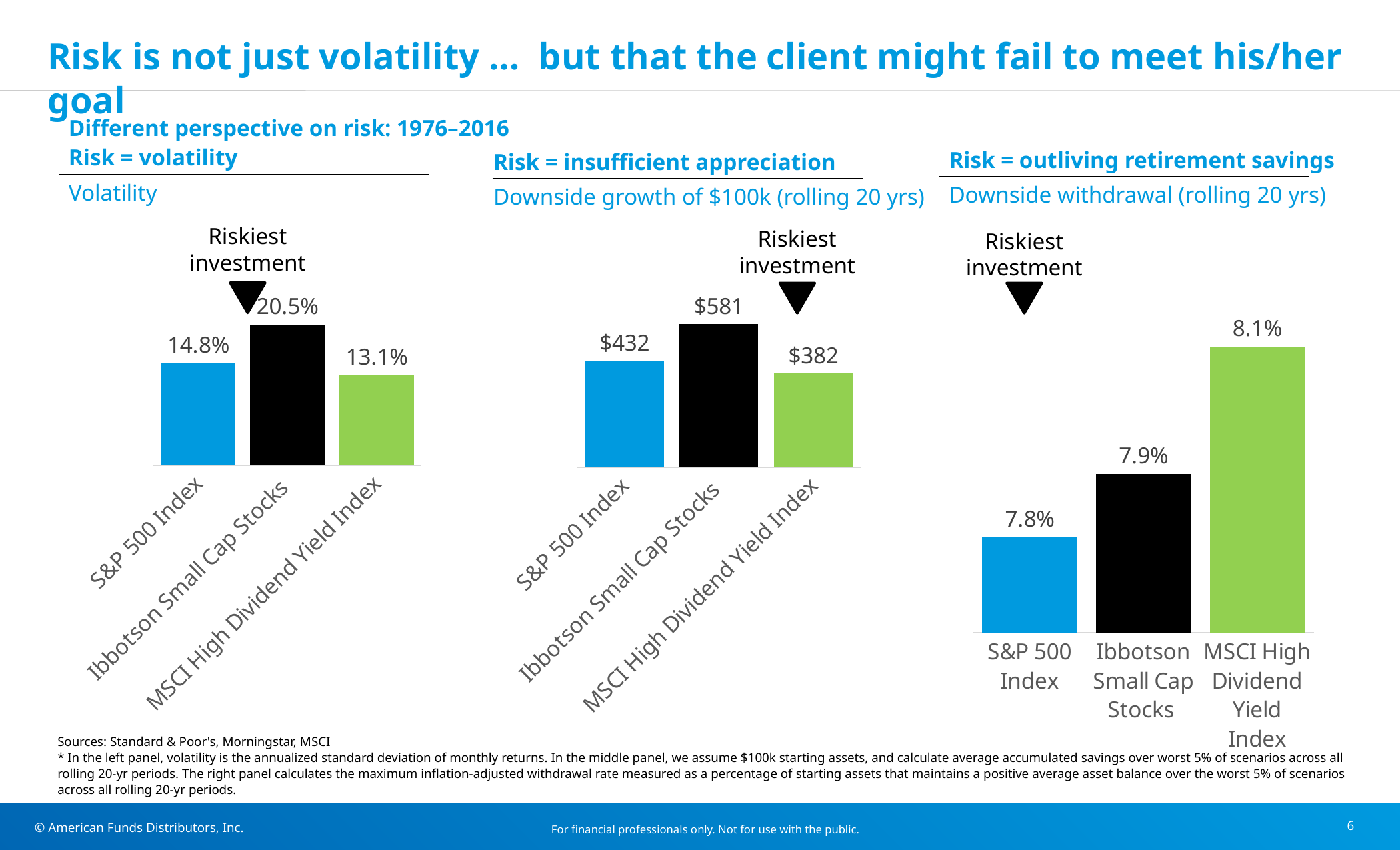
In the Downside growth of $100k chart in the middle, what is the value for the S&P 500 Index? $432 How many categories are shown in the Volatility chart on the left? 3 In the Downside growth of $100k chart in the middle, what is the difference between Ibbotson Small Cap Stocks and the MSCI High Dividend Yield Index? $199 In the Downside withdrawal chart on the right, do the values rise or fall from left to right across the categories? Rise In the Downside withdrawal chart on the right, what is the value for the MSCI High Dividend Yield Index? 8.1% In the Downside withdrawal chart on the right, what is the value for the S&P 500 Index? 7.8% In the Downside withdrawal chart on the right, which is larger: the value for Ibbotson Small Cap Stocks or the value for the S&P 500 Index? Ibbotson Small Cap Stocks In the Volatility chart on the left, what is the value for Ibbotson Small Cap Stocks? 20.5% What kind of chart is the Downside withdrawal chart on the right? Bar chart In the Downside growth of $100k chart in the middle, which category has the highest value? Ibbotson Small Cap Stocks In the Volatility chart on the left, which category has the lowest value? MSCI High Dividend Yield Index In the Volatility chart on the left, what is the difference between the S&P 500 Index and the MSCI High Dividend Yield Index values? 1.7%